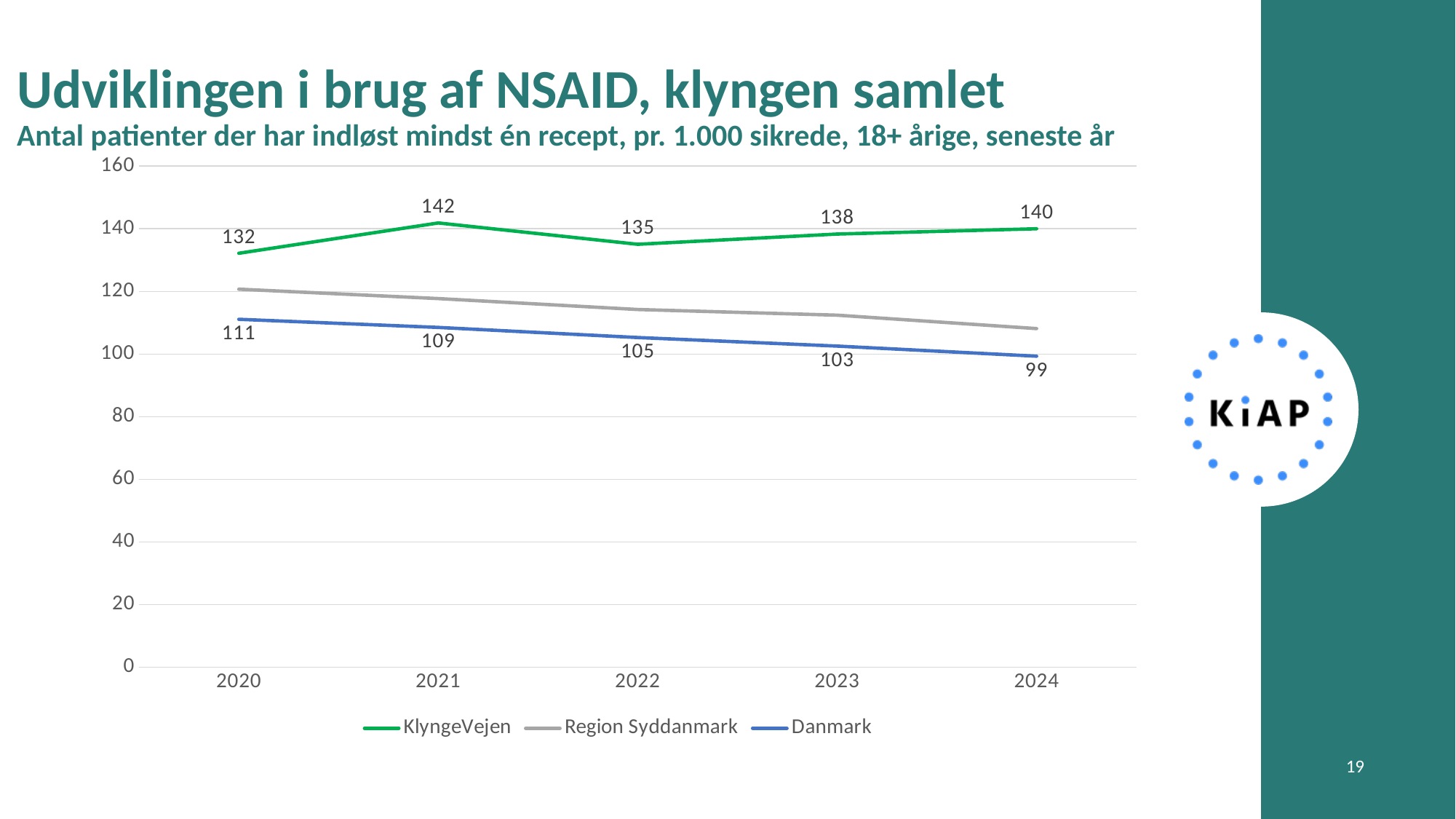
What is the value for KlyngeVejen in 2020? 132 What is the value for KlyngeVejen in 2021? 142 In which year is the Danmark value lowest? 2024 Is the value for Region Syddanmark in 2020 greater or less than 100? greater What is the difference between the KlyngeVejen value and the Danmark value in 2024? 41 Which is larger in 2022: the KlyngeVejen value or the Danmark value? KlyngeVejen What kind of chart is shown on the slide? line chart Does the Danmark series rise or fall from 2020 to 2024? fall How many years are shown on the x axis? 5 How many series does the legend list? 3 What is the value for Danmark in 2024? 99 In which year is the KlyngeVejen value highest? 2021